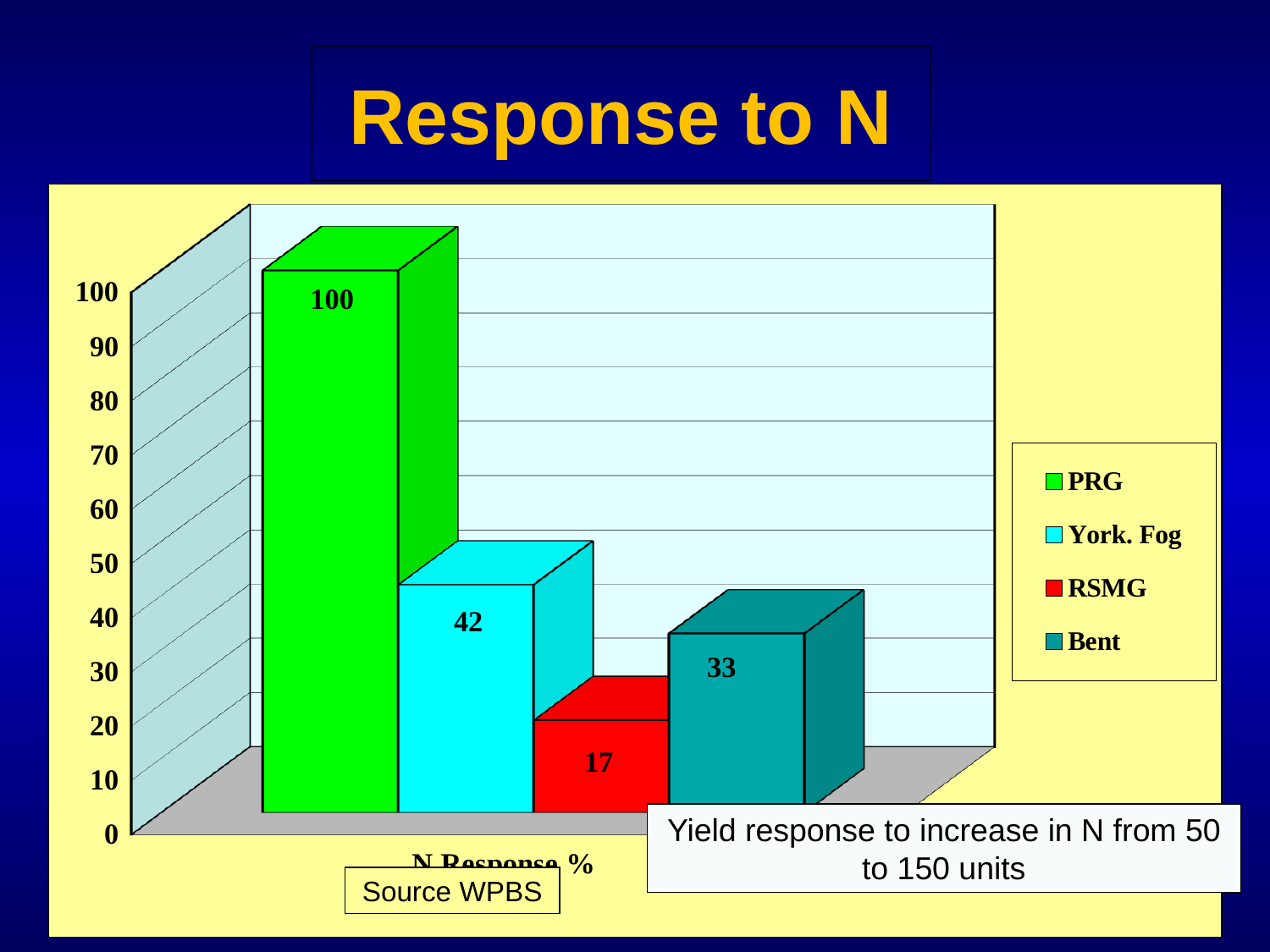
What is the value for York. Fog? 42 What is the difference between the values for PRG and York. Fog? 58 What is the value for RSMG? 17 What is the value for PRG? 100 Which series has the lowest value? RSMG Which is larger, the value for York. Fog or the value for Bent? York. Fog What kind of chart is shown on the slide? bar chart What is the value for Bent? 33 What is the difference between the values for Bent and RSMG? 16 Which series has the highest value? PRG What is the title of the slide containing the chart? Response to N How many series does the legend list? 4